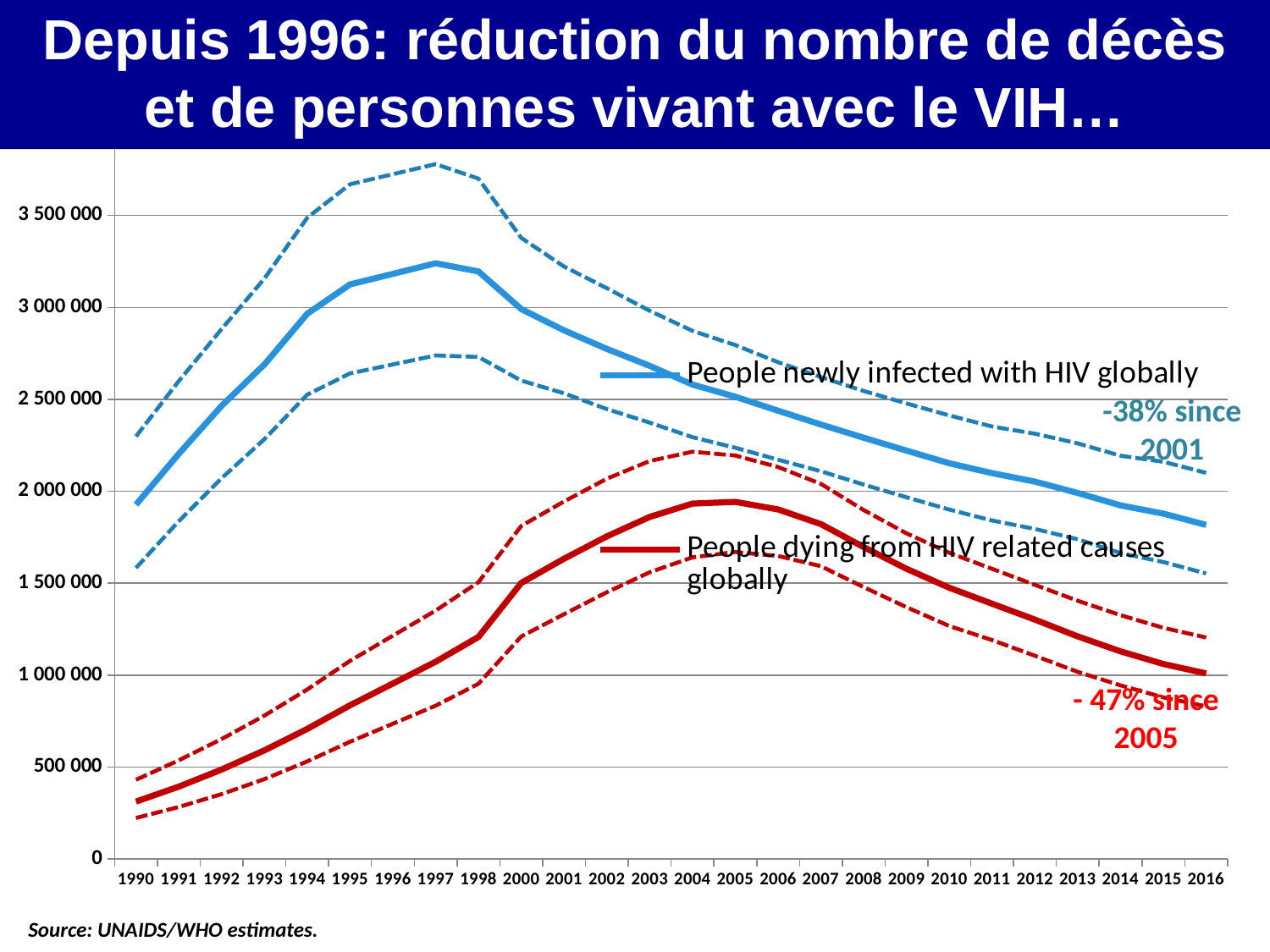
How many solid-line series are labelled on the chart? 2 Is the value for people dying from HIV related causes globally in 1990 greater or less than 500 000? less Is the value for people newly infected with HIV globally in 2005 greater or less than 2 000 000? greater How many years are labelled on the x axis? 26 Which series has the higher value in 2016, people newly infected with HIV globally or people dying from HIV related causes globally? People newly infected with HIV globally In which year does the solid line for people newly infected with HIV globally reach its highest value? 1997 What kind of chart is shown on the slide? line chart Is the value for people dying from HIV related causes globally in 2005 greater or less than 1 500 000? greater What percentage change since 2001 is annotated for people newly infected with HIV globally? -38% What is the label of the blue solid line? People newly infected with HIV globally Does the solid line for people dying from HIV related causes globally rise or fall between 2005 and 2016? fall